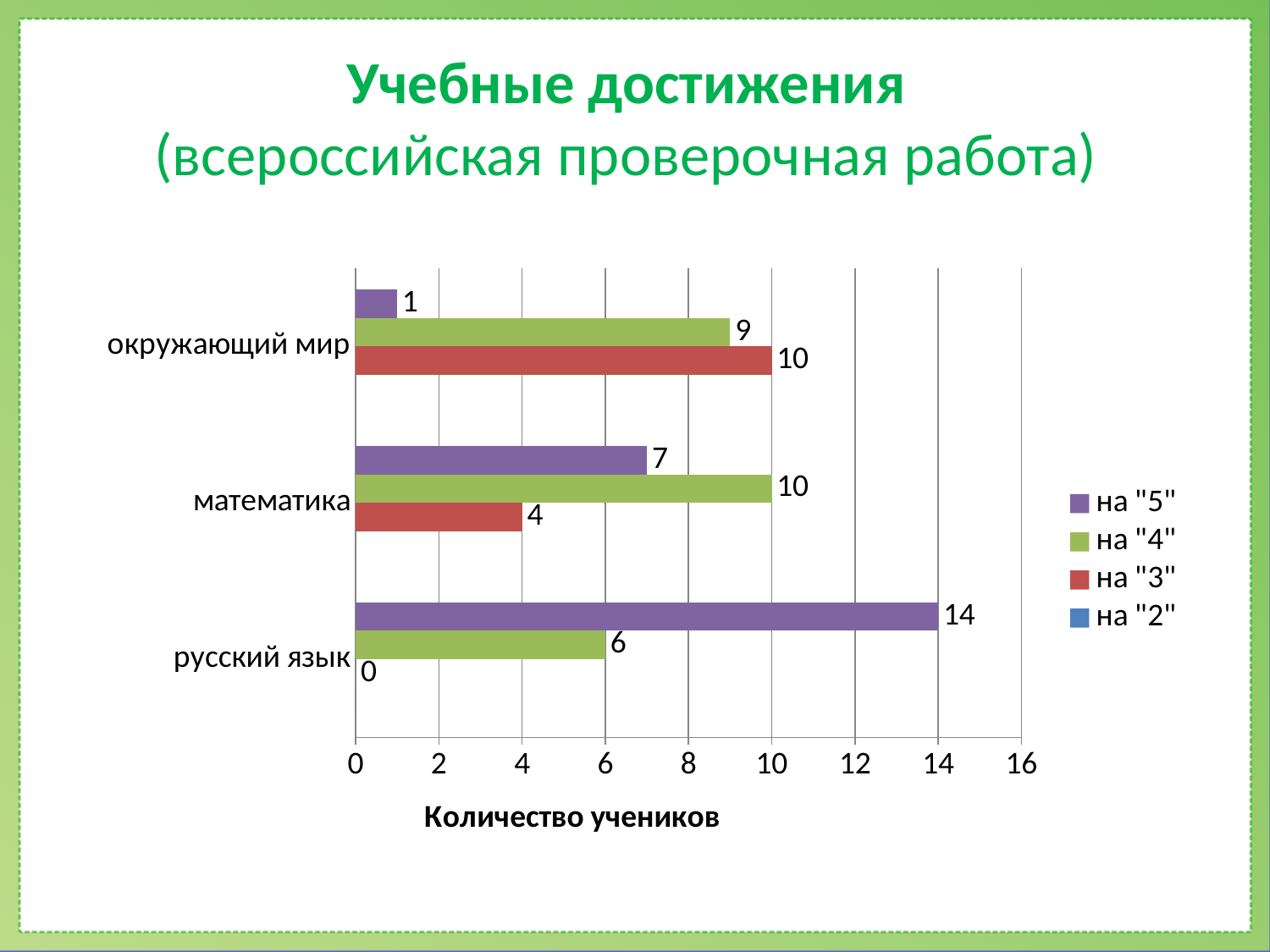
How many students got a "3" in окружающий мир? 10 How many series does the legend list? 4 What kind of chart is shown on the slide? bar chart What is the difference between the number of students with a "4" and with a "3" in математика? 6 How many students got a "3" in русский язык? 0 What is the title of the horizontal axis? Количество учеников How many students got a "5" in русский язык? 14 How many students got a "4" in математика? 10 How many subjects (categories) are shown on the chart? 3 Which subject has the lowest number of students with a "5"? окружающий мир Which subject has the highest number of students with a "5"? русский язык Which is larger: the number of students with a "4" in окружающий мир or with a "4" in русский язык? окружающий мир